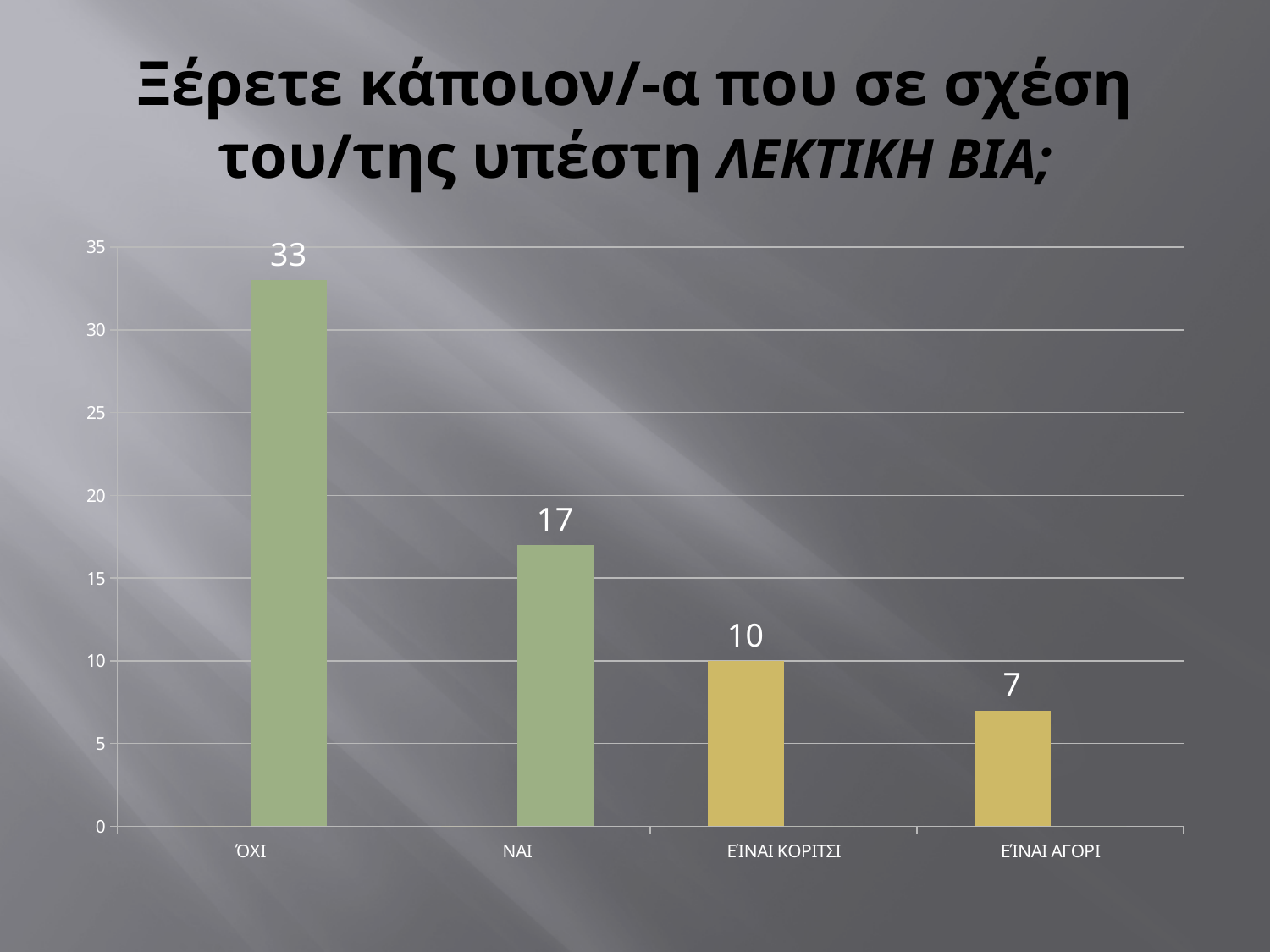
Which category has the lowest value? ΕΊΝΑΙ ΑΓΟΡΙ What is the difference between the values for ΌΧΙ and ΝΑΙ? 16 What is the value for ΝΑΙ? 17 Do the values rise or fall from left to right along the x axis? fall What kind of chart is shown on the slide? bar chart What is the value for ΕΊΝΑΙ ΚΟΡΙΤΣΙ? 10 What is the value for ΕΊΝΑΙ ΑΓΟΡΙ? 7 Which is larger, the value for ΝΑΙ or the value for ΕΊΝΑΙ ΚΟΡΙΤΣΙ? ΝΑΙ How many categories are shown on the x axis? 4 What is the value for ΌΧΙ? 33 What is the difference between the values for ΕΊΝΑΙ ΚΟΡΙΤΣΙ and ΕΊΝΑΙ ΑΓΟΡΙ? 3 Which category has the highest value? ΌΧΙ